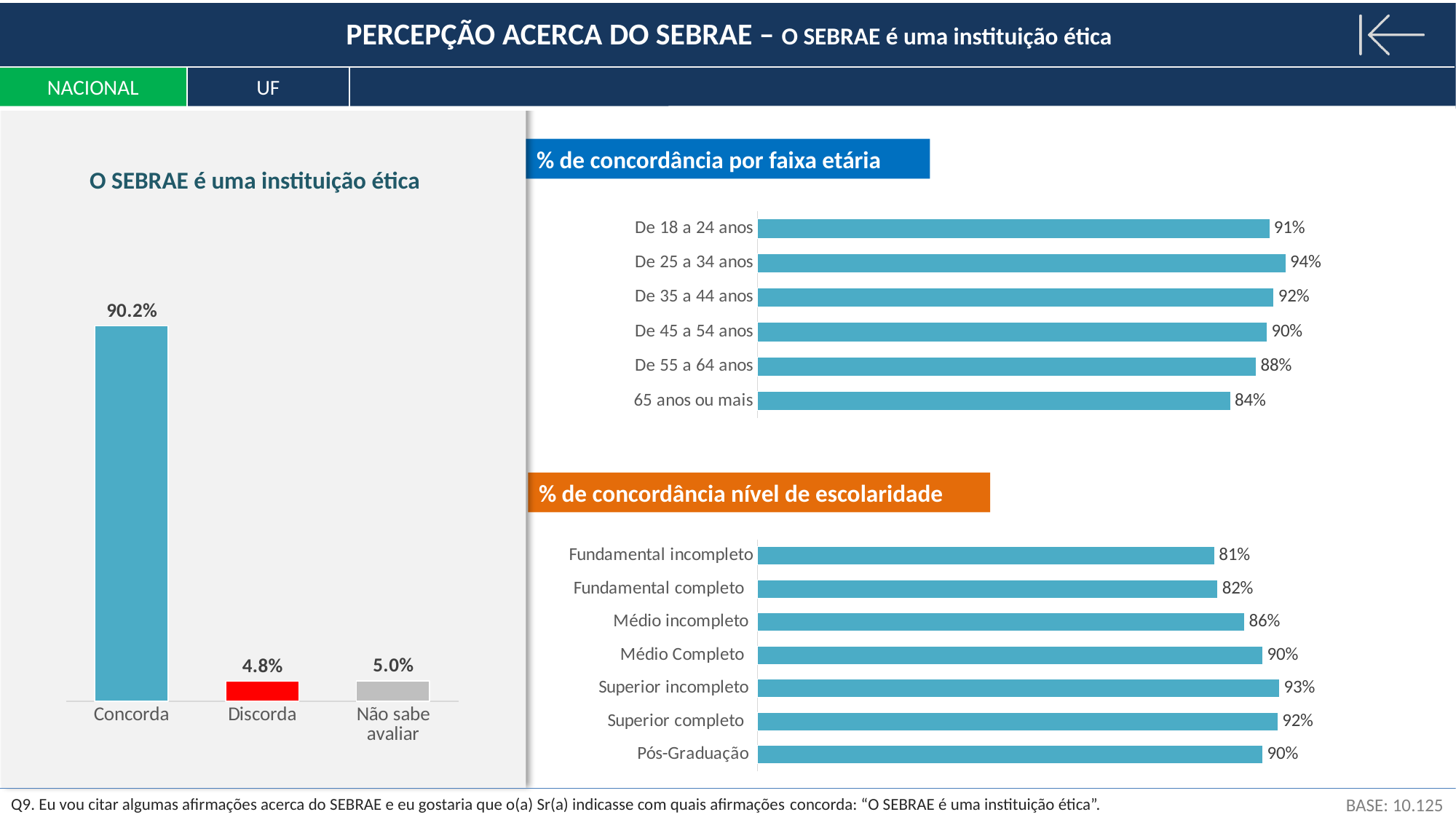
In the chart '% de concordância nível de escolaridade', which category has the lowest value? Fundamental incompleto In the chart titled 'O SEBRAE é uma instituição ética', how many categories are shown? 3 In the chart '% de concordância por faixa etária', which age group has the highest value? De 25 a 34 anos In the chart '% de concordância nível de escolaridade', what is the value for Superior incompleto? 93% In the chart titled 'O SEBRAE é uma instituição ética', what is the value for Discorda? 4.8% In the chart '% de concordância por faixa etária', what is the difference between De 25 a 34 anos and 65 anos ou mais? 10% In the chart titled 'O SEBRAE é uma instituição ética', what is the value for Concorda? 90.2% In the chart '% de concordância por faixa etária', what is the value for De 55 a 64 anos? 88% In the chart titled 'O SEBRAE é uma instituição ética', what is the difference between Não sabe avaliar and Discorda? 0.2% What kind of chart is '% de concordância nível de escolaridade'? Bar chart In the chart '% de concordância por faixa etária', which age group has the lowest value? 65 anos ou mais In the chart '% de concordância nível de escolaridade', which is larger, Médio incompleto or Superior completo? Superior completo